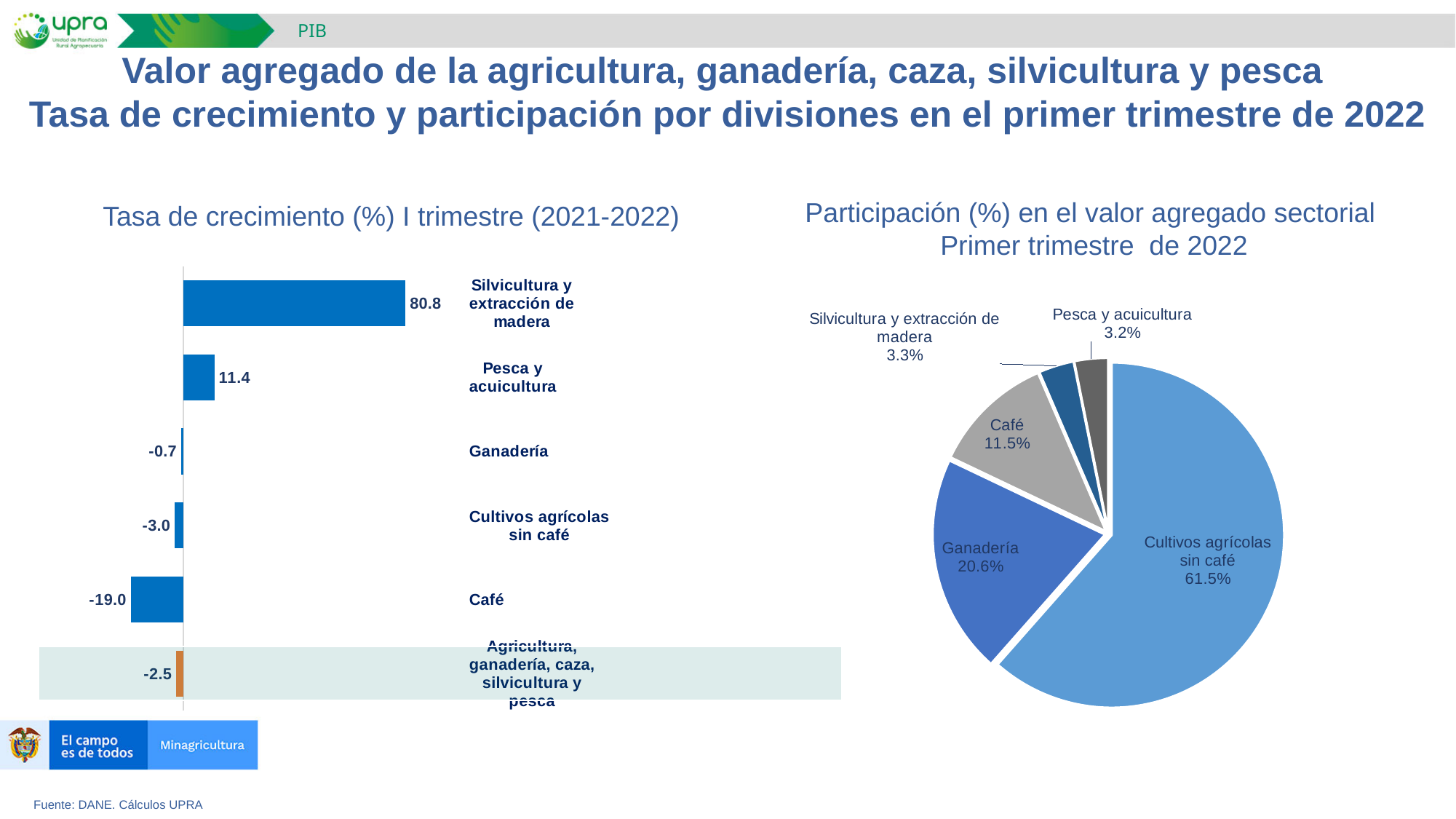
In the 'Participación (%) en el valor agregado sectorial' pie chart, which category has the smallest share? Pesca y acuicultura What kind of chart is the 'Tasa de crecimiento (%) I trimestre (2021-2022)' chart? Bar chart In the 'Tasa de crecimiento (%) I trimestre (2021-2022)' chart, what is the growth rate for Café? -19.0 In the 'Tasa de crecimiento (%) I trimestre (2021-2022)' chart, which category has the lowest growth rate? Café In the 'Participación (%) en el valor agregado sectorial' pie chart, what is the share for Ganadería? 20.6% In the 'Tasa de crecimiento (%) I trimestre (2021-2022)' chart, which is larger, the value for Ganadería or the value for Cultivos agrícolas sin café? Ganadería In the 'Participación (%) en el valor agregado sectorial' pie chart, what share does Cultivos agrícolas sin café have? 61.5% In the 'Tasa de crecimiento (%) I trimestre (2021-2022)' chart, what is the difference between the values for Silvicultura y extracción de madera and Pesca y acuicultura? 69.4 In the 'Tasa de crecimiento (%) I trimestre (2021-2022)' chart, what is the value for Pesca y acuicultura? 11.4 How many slices does the 'Participación (%) en el valor agregado sectorial' pie chart have? 5 In the 'Tasa de crecimiento (%) I trimestre (2021-2022)' chart, what is the growth rate for Silvicultura y extracción de madera? 80.8 In the 'Tasa de crecimiento (%) I trimestre (2021-2022)' chart, which category has the highest growth rate? Silvicultura y extracción de madera